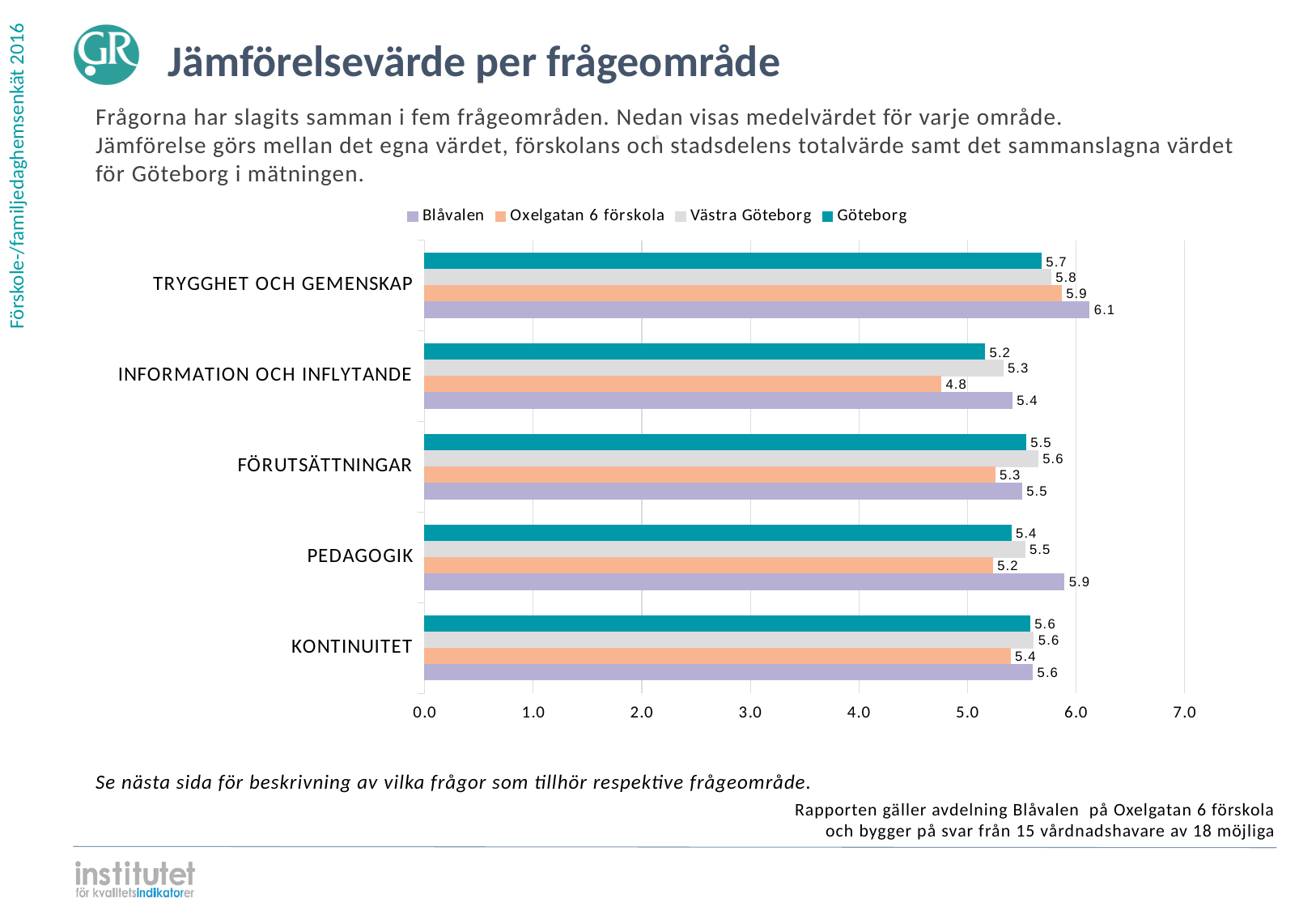
In which category does Blåvalen have its highest value? TRYGGHET OCH GEMENSKAP In the FÖRUTSÄTTNINGAR category, which is larger: the value for Västra Göteborg or the value for Oxelgatan 6 förskola? Västra Göteborg What is the difference between the Blåvalen value and the Oxelgatan 6 förskola value in the PEDAGOGIK category? 0.7 What kind of chart is shown on the slide? Bar chart How many question areas (categories) are shown on the chart? 5 Which series is shown in teal in the legend? Göteborg In which category does Oxelgatan 6 förskola have its lowest value? INFORMATION OCH INFLYTANDE How many series does the legend list? 4 What is the value for Blåvalen in the TRYGGHET OCH GEMENSKAP category? 6.1 What is the value for Oxelgatan 6 förskola in the INFORMATION OCH INFLYTANDE category? 4.8 What is the value for Västra Göteborg in the KONTINUITET category? 5.6 What is the value for Göteborg in the PEDAGOGIK category? 5.4